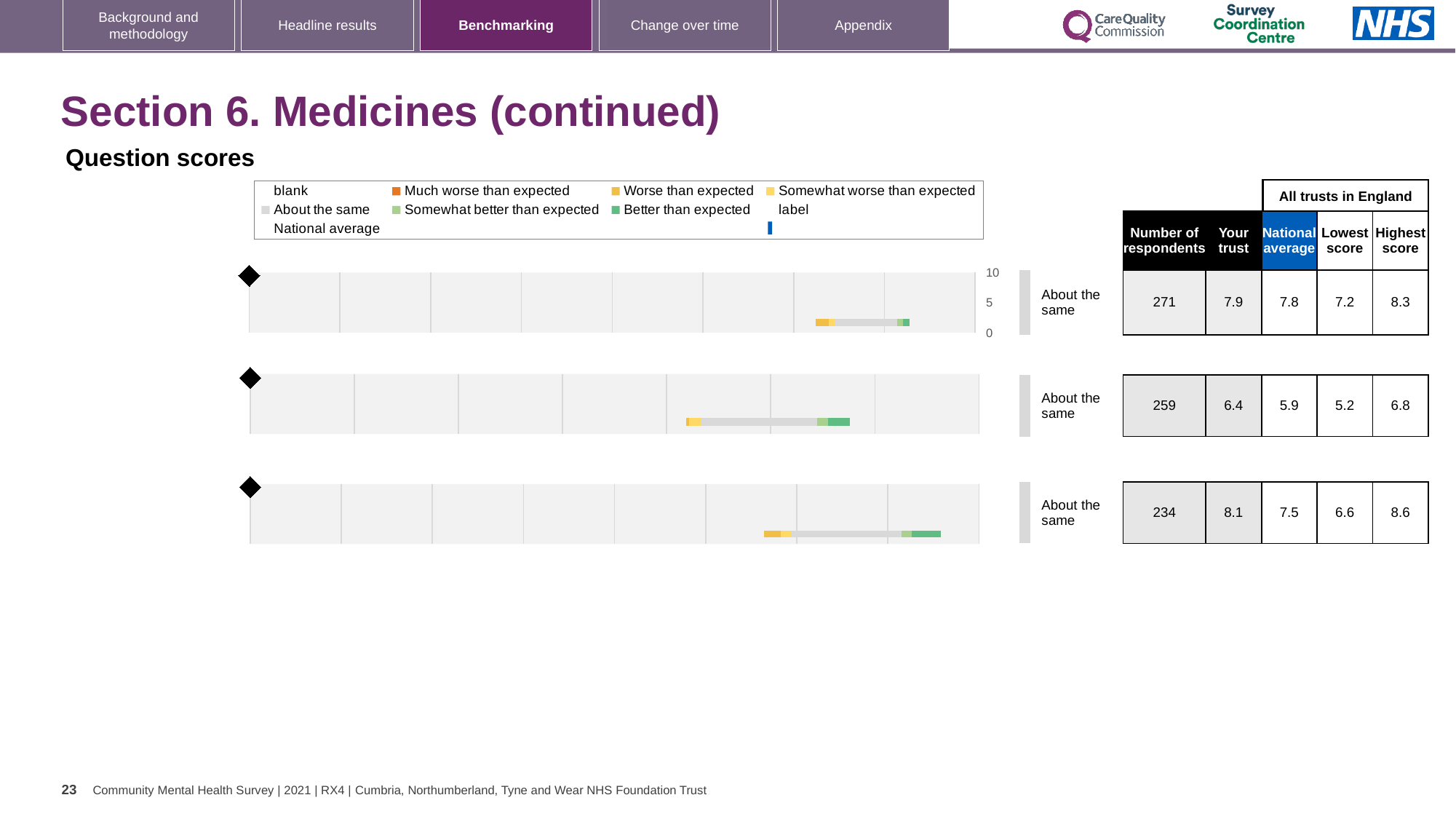
For the bottom chart, what is the national average score shown in the table beside it? 7.5 Which of the three charts has the highest 'Your trust' score in its table? The bottom chart (8.1) How many entries does the legend above the charts list? 9 What benchmark category label is shown to the right of each of the three charts? About the same For the middle chart, how many respondents are shown in the table beside it? 259 What kind of chart is used on this slide to show the question scores? Bar chart In the legend, what colour represents 'Much worse than expected'? Orange For the top chart, which is larger: the 'Your trust' score or the national average? Your trust How many separate question-score charts are shown on the slide? 3 For the bottom chart, what is the difference between the highest score (8.6) and the lowest score (6.6) in the table? 2.0 In the legend, what colour represents 'Better than expected'? Green For the top chart, what is the 'Your trust' score shown in the table beside it? 7.9